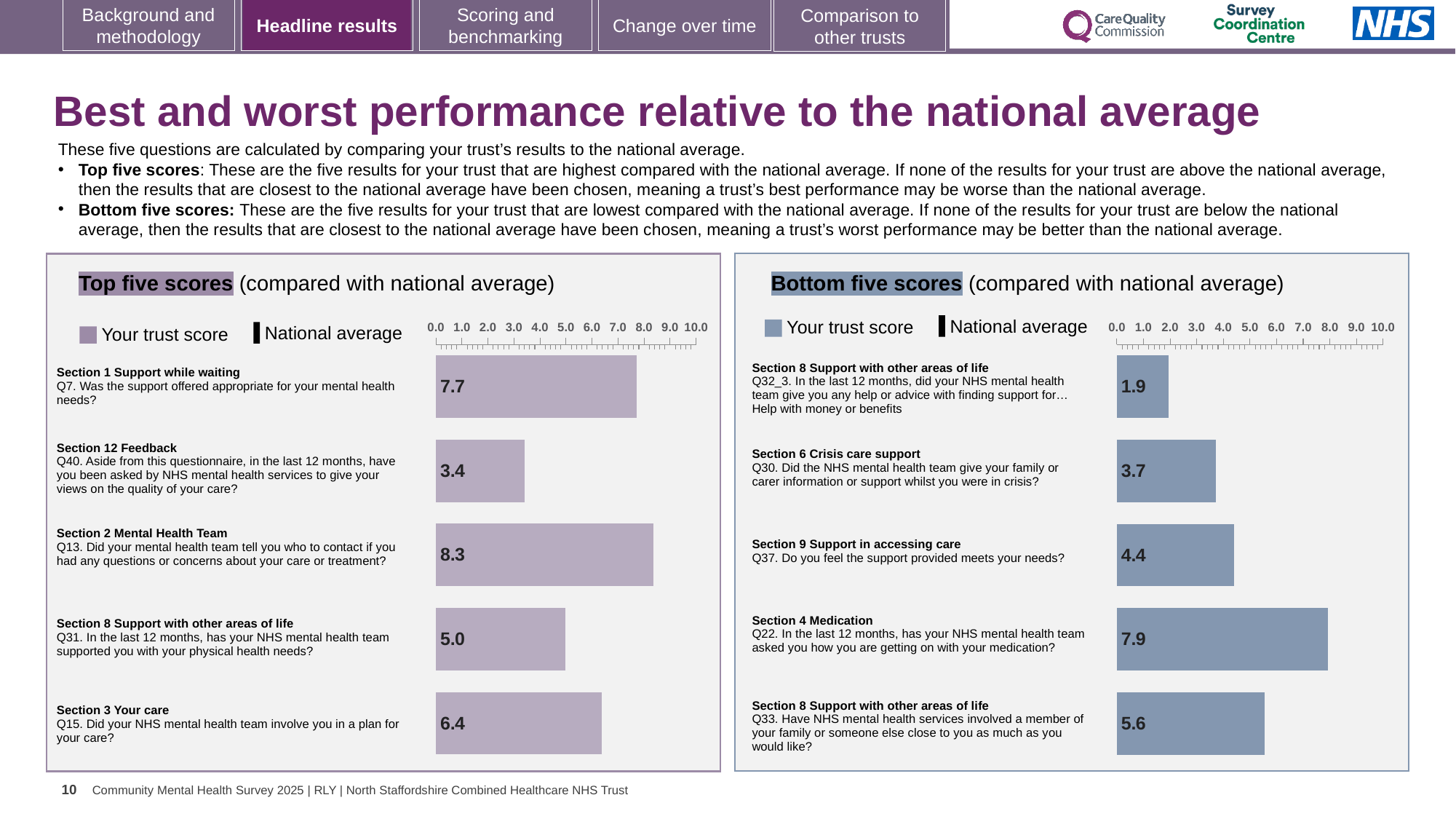
What kind of chart is the Top five scores chart? Bar chart In the Bottom five scores chart, what is the trust score for Q22 (has your NHS mental health team asked you how you are getting on with your medication?)? 7.9 In the Top five scores chart, what is the trust score for Q13 (Did your mental health team tell you who to contact if you had any questions or concerns about your care or treatment?)? 8.3 In the Bottom five scores chart, which question has the lowest trust score? Q32_3 (Section 8 Support with other areas of life, help with money or benefits) How many series does the legend of the Bottom five scores chart list? 2 In the Bottom five scores chart, what is the difference between the trust scores for Q22 and Q33? 2.3 In the Top five scores chart, what is the trust score for Q31 (has your NHS mental health team supported you with your physical health needs?)? 5.0 In the Top five scores chart, which question has the highest trust score? Q13 (Section 2 Mental Health Team) In the Top five scores chart, is the trust score for Q15 greater or less than 5.0? greater In the Top five scores chart, what is the difference between the trust scores for Q13 and Q40? 4.9 How many bars are plotted in the Top five scores chart? 5 In the Bottom five scores chart, which has the larger trust score: Q30 or Q37? Q37